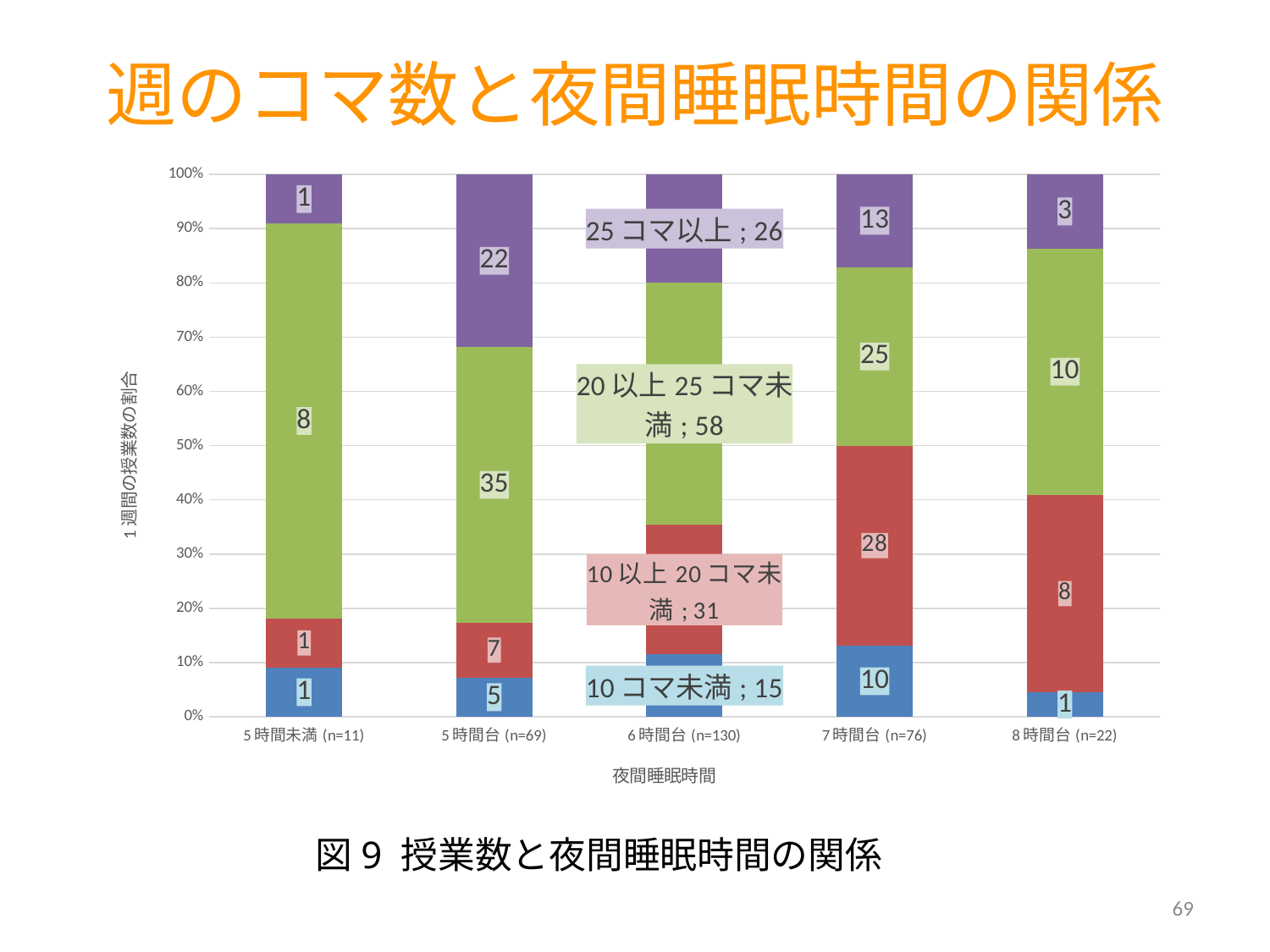
What is the label of the x axis? 夜間睡眠時間 Which sleep-duration category has the largest count in the 25コマ以上 series? 6時間台 (n=130) What kind of chart is shown on the slide? Stacked bar chart What is the value of the 20以上25コマ未満 segment for 5時間台 (n=69)? 35 What is the value of the 10以上20コマ未満 segment for 8時間台 (n=22)? 8 In the 5時間台 (n=69) bar, what is the difference between the 20以上25コマ未満 value and the 25コマ以上 value? 13 How many series (class-count groups) are shown in the chart? 4 In the 7時間台 (n=76) bar, which is larger: the 10以上20コマ未満 value or the 20以上25コマ未満 value? 10以上20コマ未満 What is the value of the 25コマ以上 segment for 7時間台 (n=76)? 13 What is the value of the 10コマ未満 segment for 6時間台 (n=130)? 15 What is the total of all segments in the 6時間台 (n=130) bar? 130 How many sleep-duration categories are shown on the x axis? 5